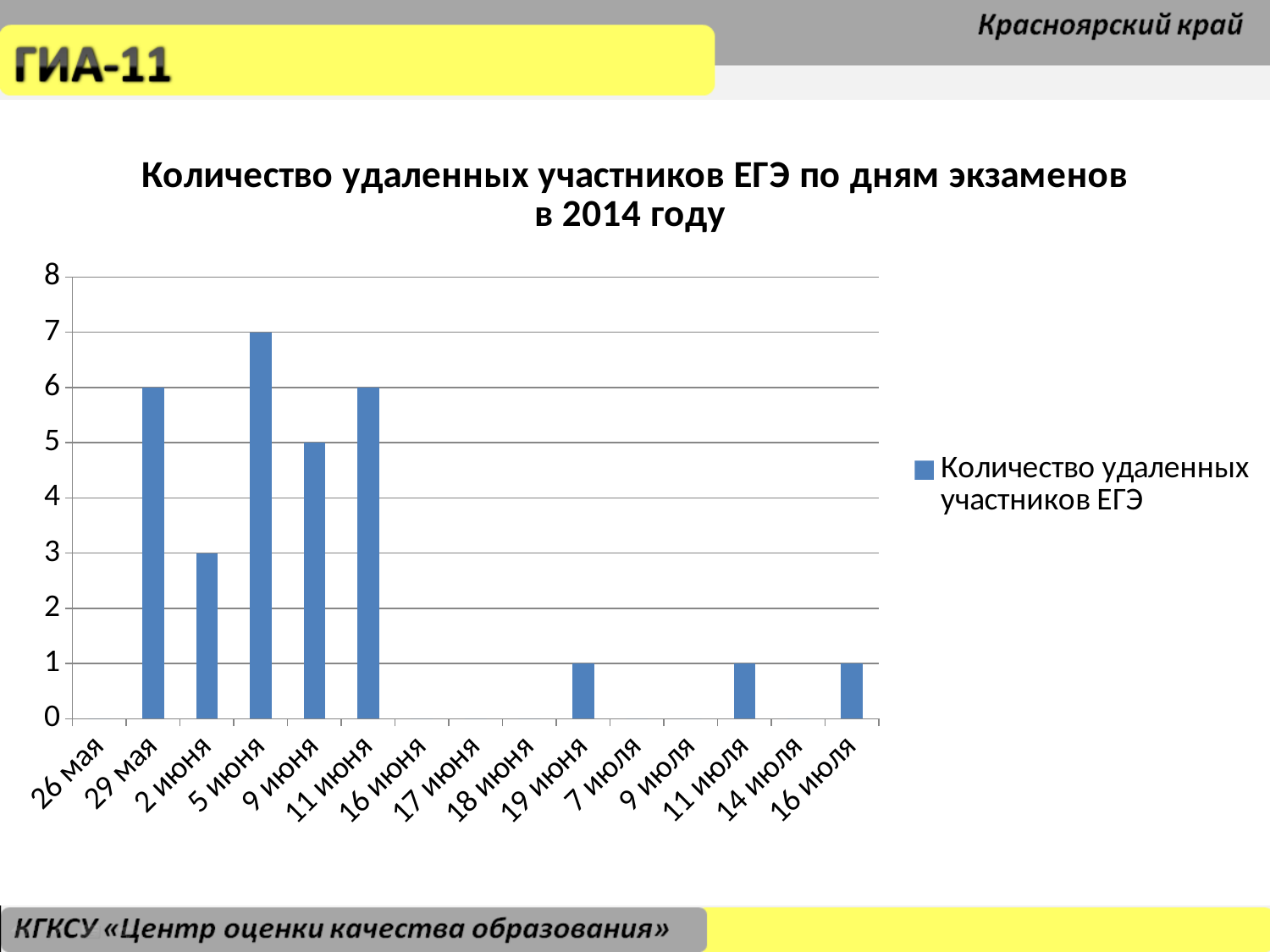
Which is larger, the value for 9 июня or the value for 11 июня? 11 июня Which exam day has the highest number of removed participants? 5 июня What is the value for 2 июня? 3 What is the difference between the values for 5 июня and 2 июня? 4 What type of chart is shown on the slide? bar chart What is the value for 19 июня? 1 How many series does the legend list? 1 What is the value for 29 мая? 6 What is the value for 9 июня? 5 What is the value for 5 июня? 7 How many exam-day categories are shown on the x axis? 15 Is the value for 29 мая greater or less than 4? greater